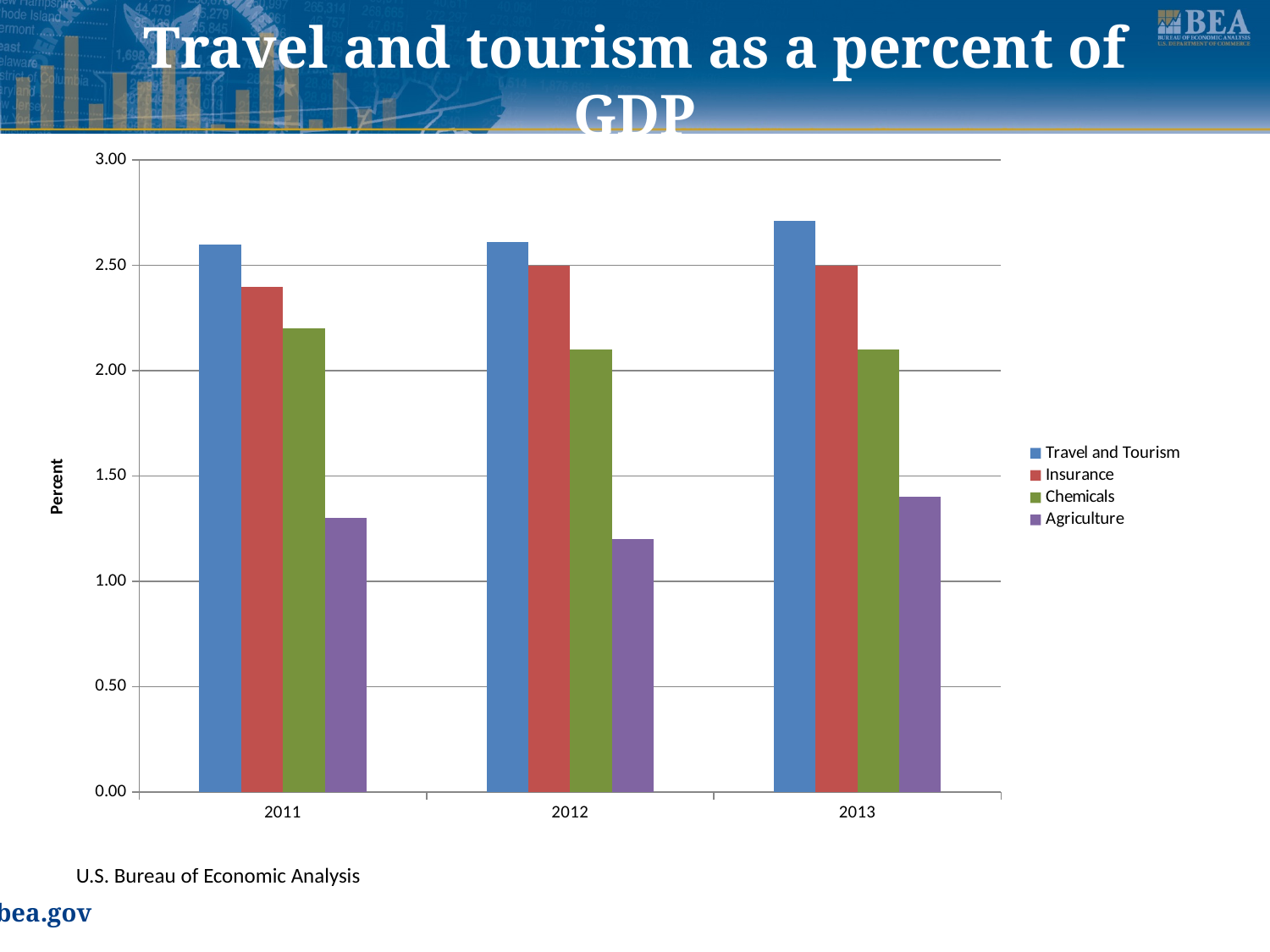
How many series does the legend list? 4 What is the label on the vertical axis? Percent Which is larger in 2012, Chemicals or Agriculture? Chemicals Does the value for Agriculture rise or fall from 2012 to 2013? Rise Is the value for Agriculture in 2012 greater or less than 1.50? less Is the value for Chemicals in 2011 greater or less than 2.00? greater Which series has the lowest value in 2011? Agriculture Which series has the highest value in 2013? Travel and Tourism Is the value for Insurance in 2011 greater or less than 2.50? less How many years are shown on the x axis? 3 What kind of chart is shown on the slide? Bar chart